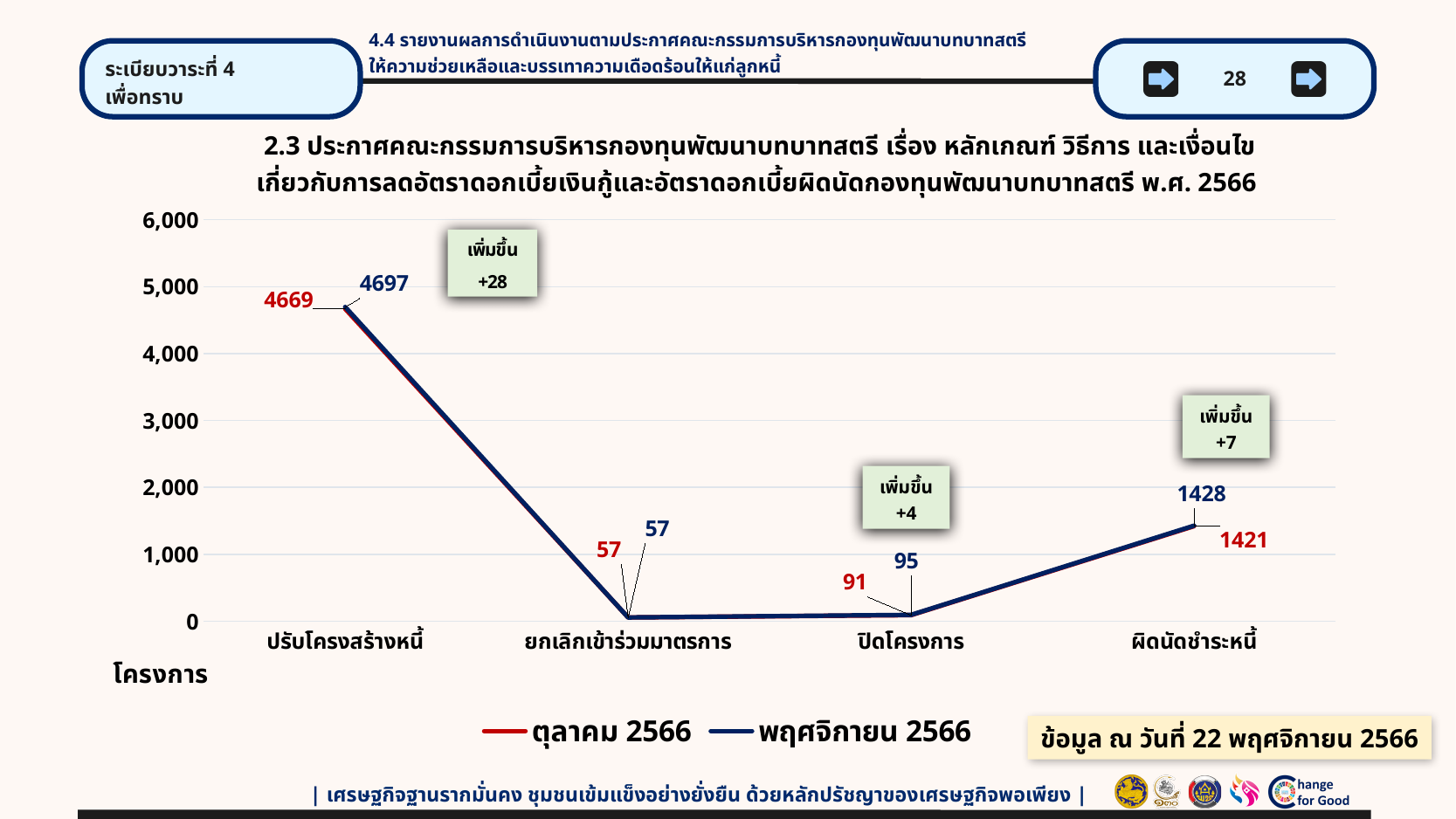
Which category has the lowest value in the ตุลาคม 2566 series? ยกเลิกเข้าร่วมมาตรการ What is the value for ปิดโครงการ in the พฤศจิกายน 2566 series? 95 Which category has the highest value in the พฤศจิกายน 2566 series? ปรับโครงสร้างหนี้ What is the difference between the พฤศจิกายน 2566 and ตุลาคม 2566 values for ผิดนัดชำระหนี้? 7 What is the value for ปรับโครงสร้างหนี้ in the พฤศจิกายน 2566 series? 4697 Which series is drawn in red in the legend? ตุลาคม 2566 What kind of chart is shown on the slide? line chart How many categories are shown on the x axis? 4 Which is larger for ปิดโครงการ: the ตุลาคม 2566 value or the พฤศจิกายน 2566 value? พฤศจิกายน 2566 What is the value for ปรับโครงสร้างหนี้ in the ตุลาคม 2566 series? 4669 How many series does the legend list? 2 What is the value for ผิดนัดชำระหนี้ in the ตุลาคม 2566 series? 1421